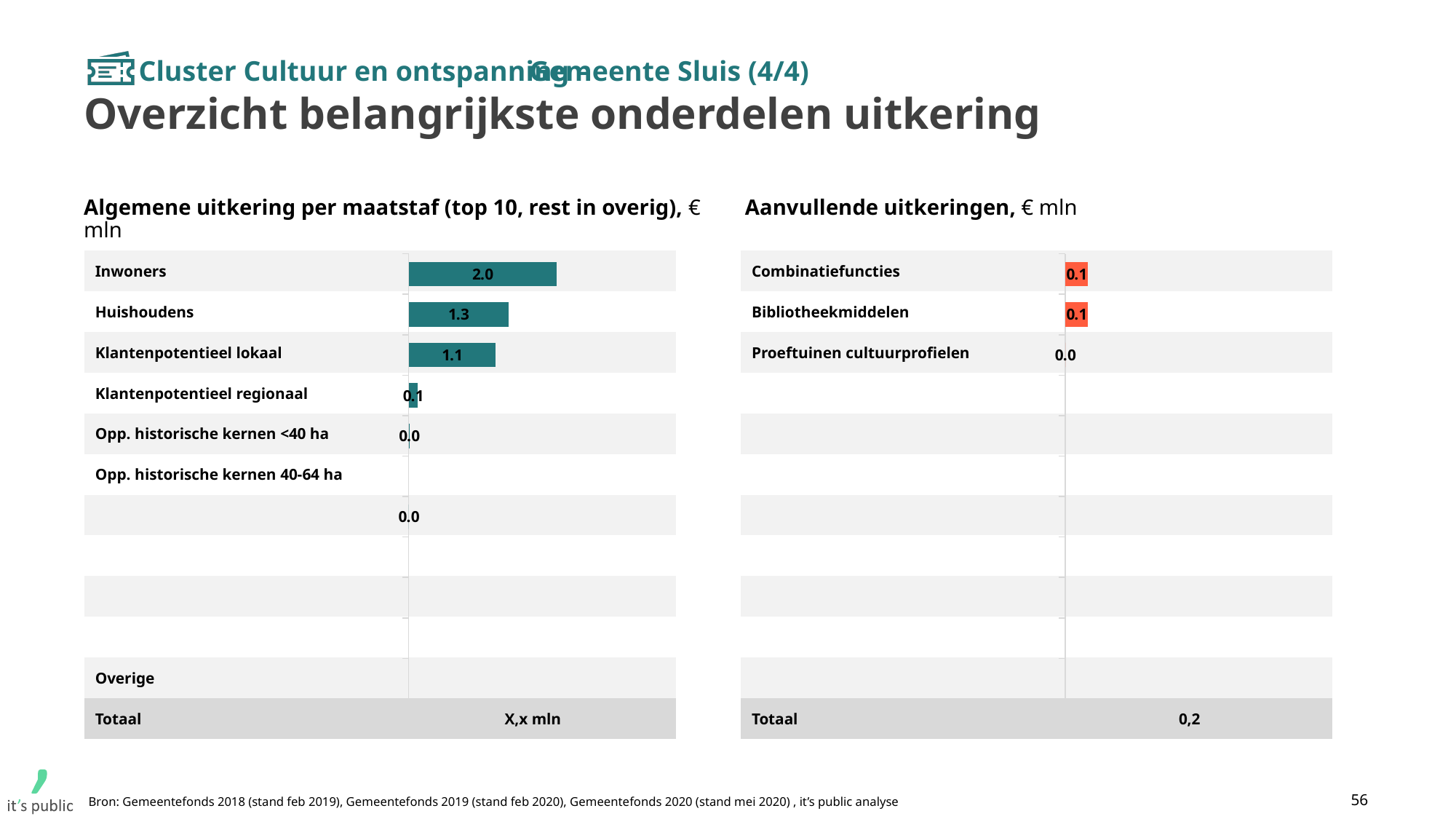
In the chart 'Algemene uitkering per maatstaf', what is the difference between Inwoners and Huishoudens? 0.7 In the chart 'Algemene uitkering per maatstaf', what is the value for Klantenpotentieel regionaal? 0.1 In the chart 'Aanvullende uitkeringen', what is the total shown in the Totaal row? 0,2 What kind of chart is the 'Algemene uitkering per maatstaf' chart? Bar chart In the chart 'Aanvullende uitkeringen', what is the value for Combinatiefuncties? 0.1 In the chart 'Aanvullende uitkeringen', what is the value for Proeftuinen cultuurprofielen? 0.0 In the chart 'Aanvullende uitkeringen', how many labelled categories are plotted? 3 In the chart 'Algemene uitkering per maatstaf', which category has the highest value? Inwoners In the chart 'Algemene uitkering per maatstaf', what is the value for Inwoners? 2.0 In the chart 'Algemene uitkering per maatstaf', what is the value for Klantenpotentieel lokaal? 1.1 In the chart 'Algemene uitkering per maatstaf', which is larger: Huishoudens or Klantenpotentieel lokaal? Huishoudens In the chart 'Algemene uitkering per maatstaf', what is the value for Huishoudens? 1.3